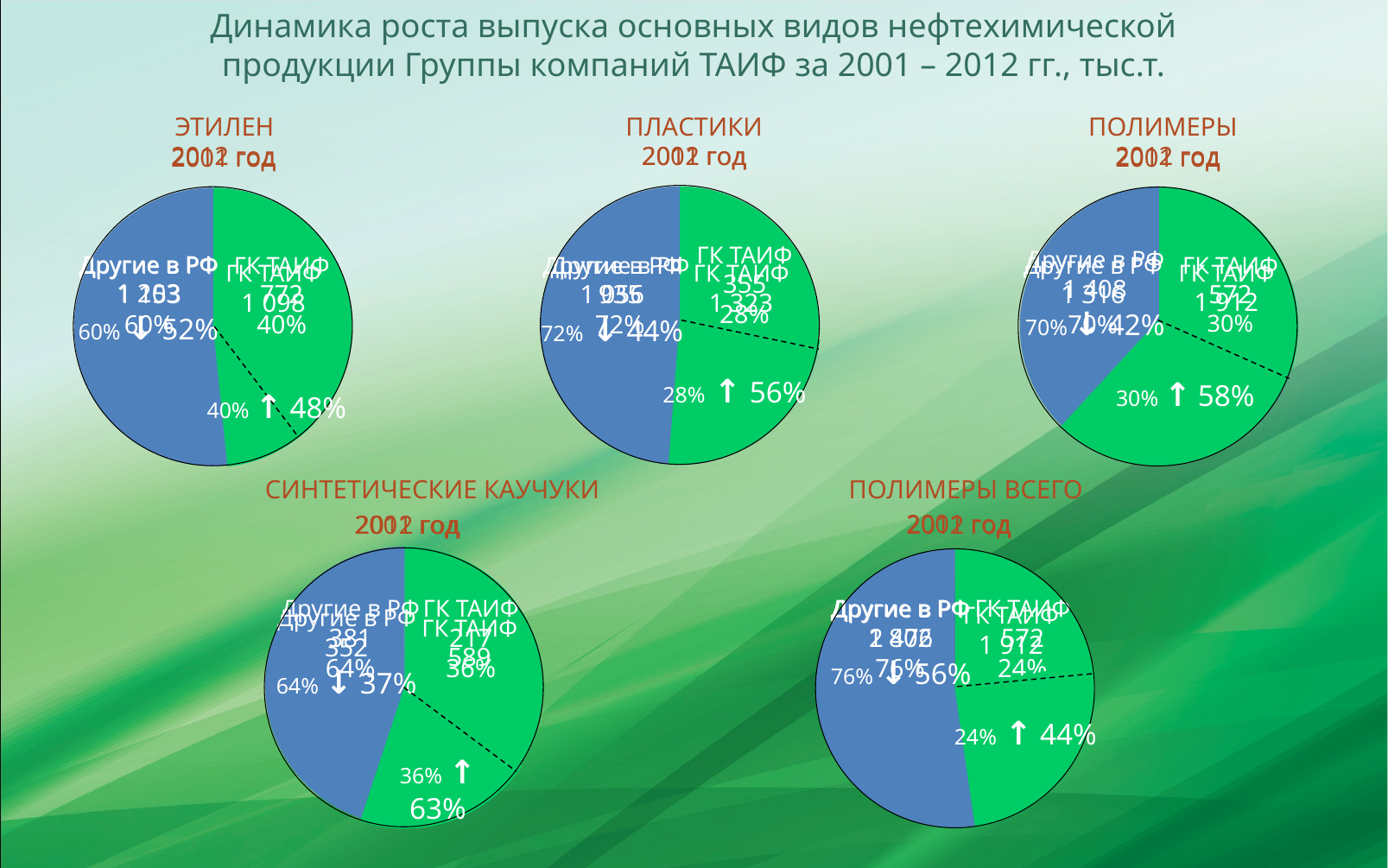
How many pie charts are on the slide? 5 How many slices does the ЭТИЛЕН pie chart have? 2 What are the two categories shown in the ПЛАСТИКИ pie chart? Другие в РФ and ГК ТАИФ In the СИНТЕТИЧЕСКИЕ КАУЧУКИ pie chart, which slice is larger, Другие в РФ or ГК ТАИФ? Другие в РФ In the ПОЛИМЕРЫ ВСЕГО pie chart, which slice is larger, Другие в РФ or ГК ТАИФ? Другие в РФ In the ПЛАСТИКИ pie chart, what percentage is shown next to the upward arrow? 56% In the ПОЛИМЕРЫ pie chart, what percentage is shown next to the upward arrow? 58% In the СИНТЕТИЧЕСКИЕ КАУЧУКИ pie chart, what percentage is shown next to the upward arrow? 63% In the ЭТИЛЕН pie chart, what percentage is shown next to the upward arrow? 48% What is the title of the pie chart in the bottom right of the slide? ПОЛИМЕРЫ ВСЕГО In the ПОЛИМЕРЫ ВСЕГО pie chart, what percentage is shown next to the downward arrow? 56% What kind of charts are shown on the slide? Pie charts